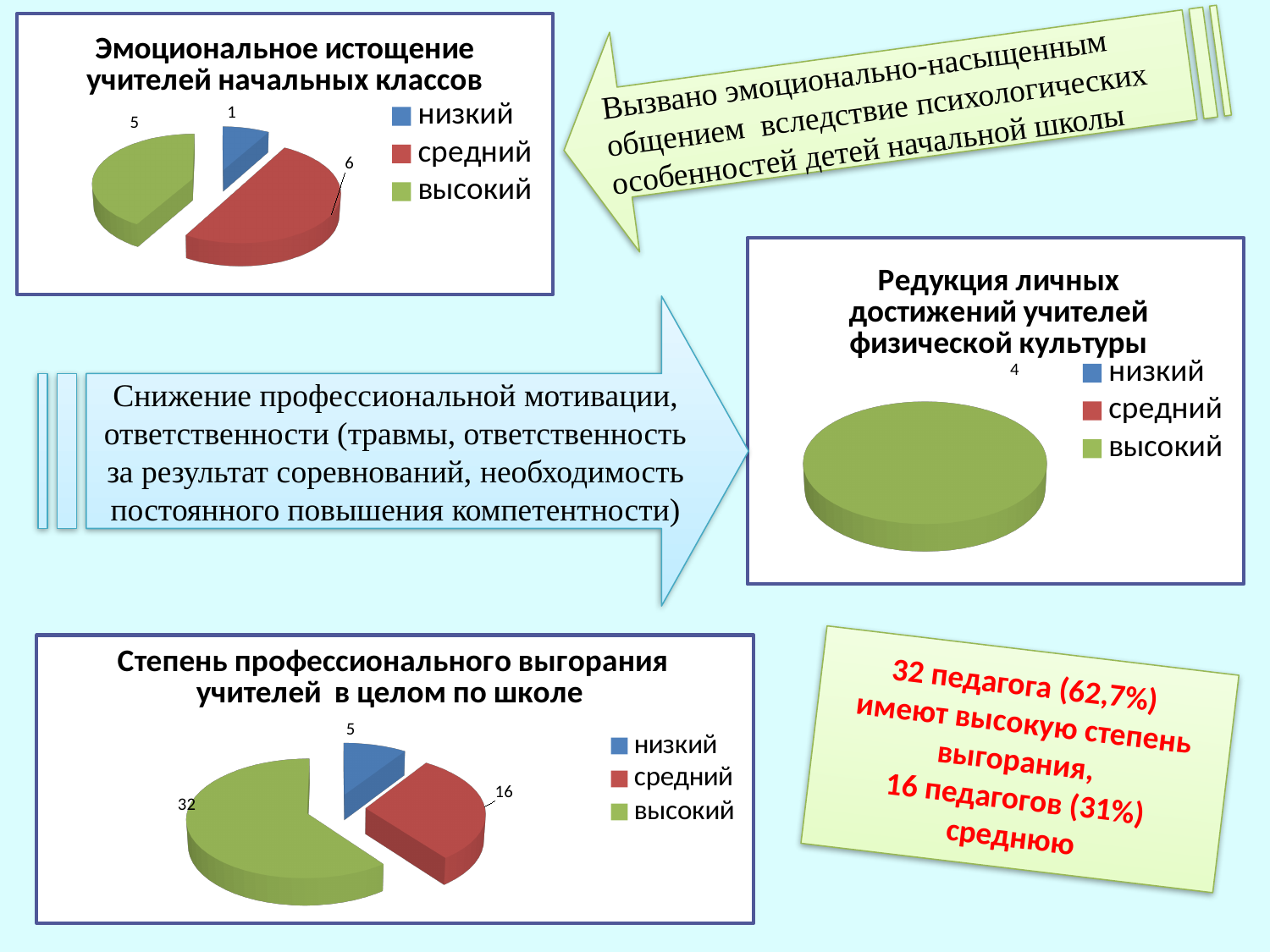
In the chart 'Степень профессионального выгорания учителей в целом по школе', which category has the smallest slice? низкий In the chart 'Эмоциональное истощение учителей начальных классов', what is the value for 'средний'? 6 In the chart 'Степень профессионального выгорания учителей в целом по школе', what is the value for 'высокий'? 32 In the chart 'Степень профессионального выгорания учителей в целом по школе', which is larger, 'средний' or 'низкий'? средний In the chart 'Редукция личных достижений учителей физической культуры', how many slices are actually plotted in the pie? 1 In the chart 'Эмоциональное истощение учителей начальных классов', what is the difference between 'средний' and 'высокий'? 1 In the chart 'Степень профессионального выгорания учителей в целом по школе', what is the value for 'средний'? 16 In the chart 'Редукция личных достижений учителей физической культуры', what is the value for 'высокий'? 4 What type of chart is 'Степень профессионального выгорания учителей в целом по школе'? pie chart In the chart 'Эмоциональное истощение учителей начальных классов', which category has the largest slice? средний In the chart 'Степень профессионального выгорания учителей в целом по школе', what is the difference between 'высокий' and 'средний'? 16 In the chart 'Эмоциональное истощение учителей начальных классов', what is the value for 'низкий'? 1